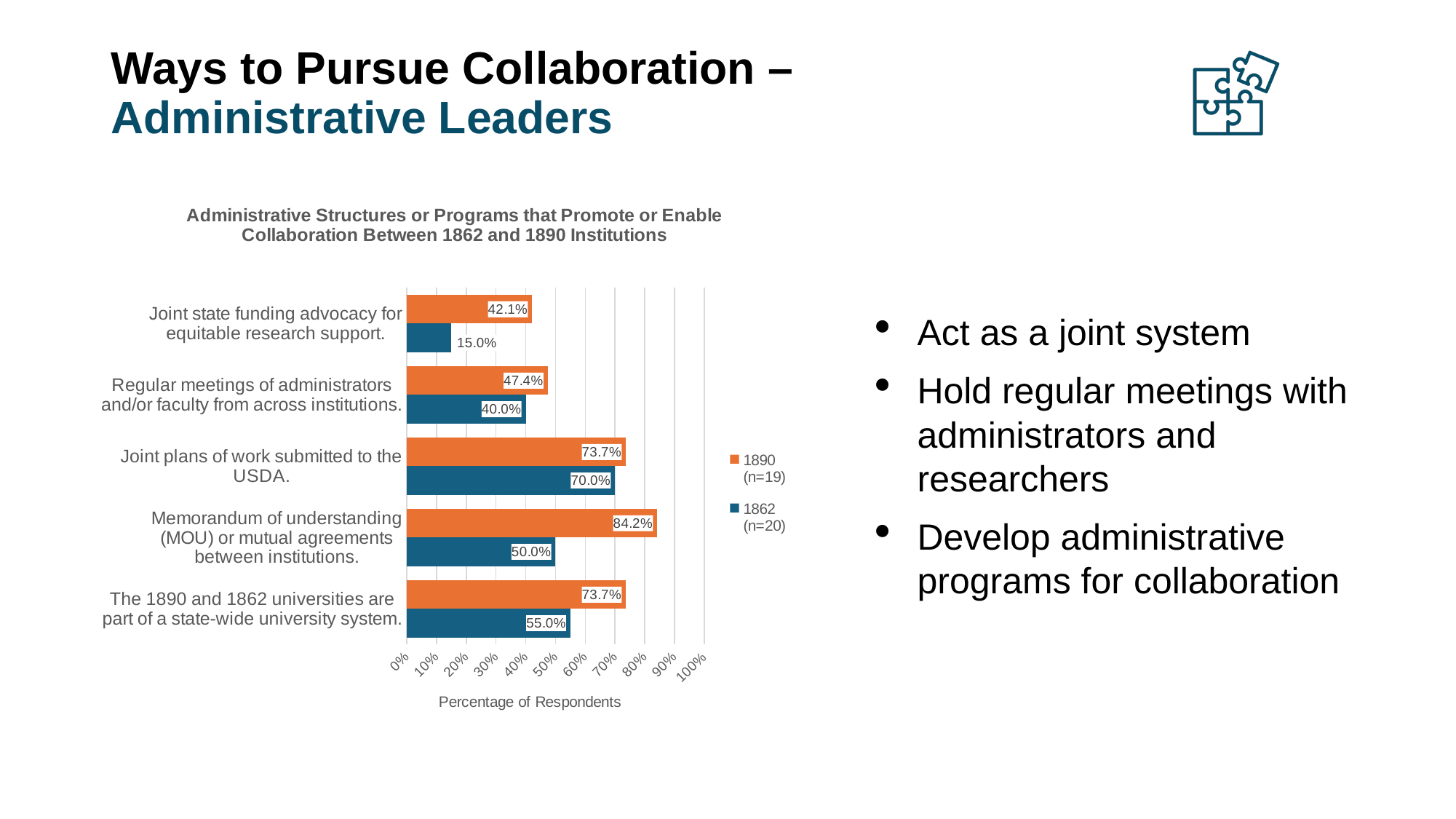
What percentage of 1890 respondents selected "Memorandum of understanding (MOU) or mutual agreements between institutions"? 84.2% Which category has the lowest value for the 1862 series? Joint state funding advocacy for equitable research support. What is the label of the horizontal axis? Percentage of Respondents How many series does the legend list? 2 What is the difference between the 1890 and 1862 values for "Memorandum of understanding (MOU) or mutual agreements between institutions"? 34.2% What is the value for the 1862 series for "Joint plans of work submitted to the USDA"? 70.0% How many categories are shown on the chart? 5 For "The 1890 and 1862 universities are part of a state-wide university system", which series has the larger value, 1890 or 1862? 1890 What percentage of 1862 respondents selected "Joint state funding advocacy for equitable research support"? 15.0% What type of chart is shown on the slide? Bar chart What is the title of the chart? Administrative Structures or Programs that Promote or Enable Collaboration Between 1862 and 1890 Institutions Which category has the highest value for the 1890 series? Memorandum of understanding (MOU) or mutual agreements between institutions.